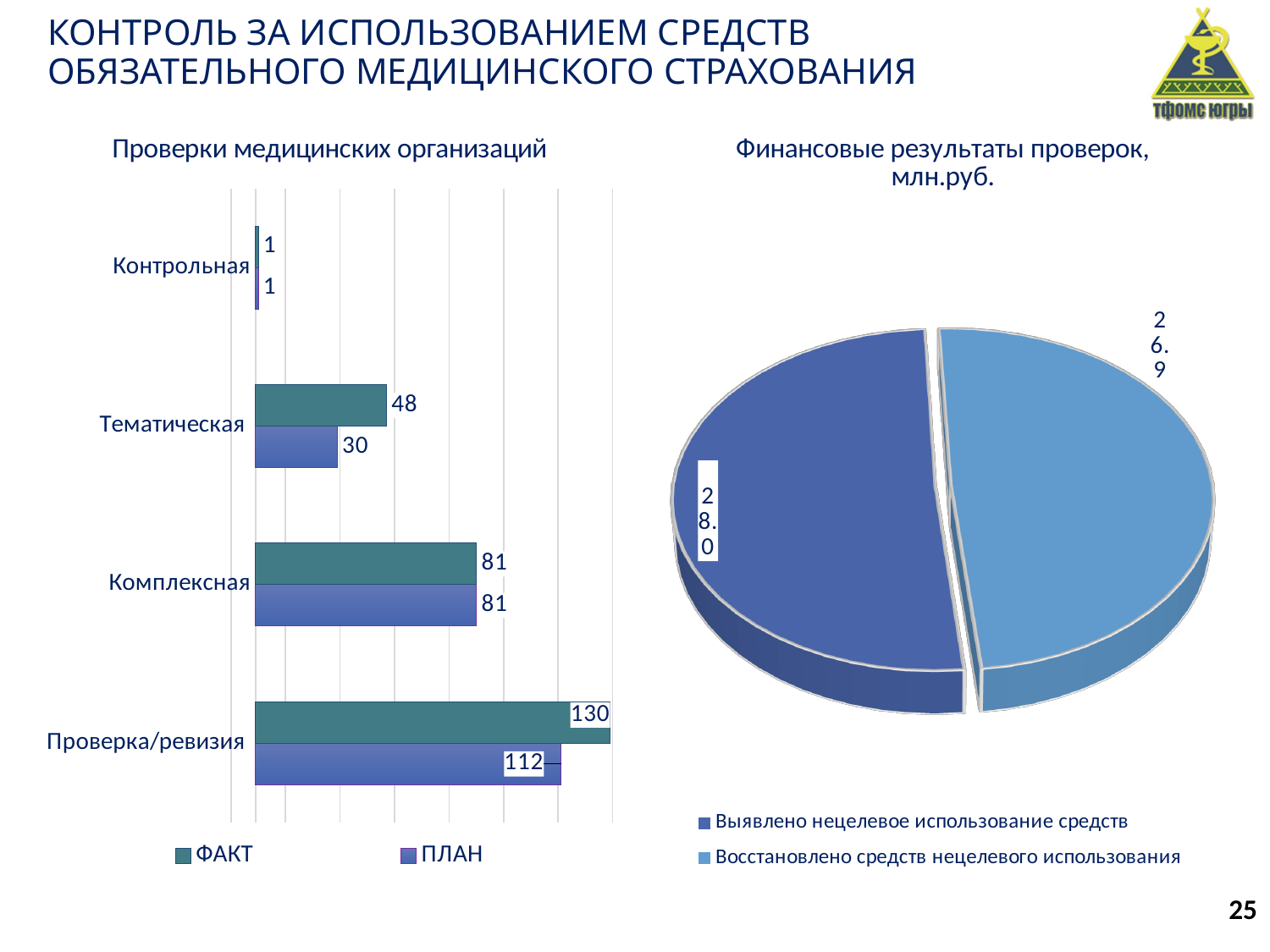
In the chart 'Проверки медицинских организаций', what is the ФАКТ value for Проверка/ревизия? 130 In the chart 'Проверки медицинских организаций', which is larger for Проверка/ревизия: ФАКТ or ПЛАН? ФАКТ In the pie chart 'Финансовые результаты проверок, млн.руб.', what is the value for 'Восстановлено средств нецелевого использования'? 26.9 How many categories are shown in the chart 'Проверки медицинских организаций'? 4 In the chart 'Проверки медицинских организаций', what is the ПЛАН value for Тематическая? 30 In the chart 'Проверки медицинских организаций', what is the ПЛАН value for Проверка/ревизия? 112 In the chart 'Проверки медицинских организаций', what is the difference between the ФАКТ and ПЛАН values for Тематическая? 18 How many series does the legend of the chart 'Проверки медицинских организаций' list? 2 In the chart 'Проверки медицинских организаций', which category has the lowest ПЛАН value? Контрольная In the pie chart 'Финансовые результаты проверок, млн.руб.', what is the value for 'Выявлено нецелевое использование средств'? 28.0 In the chart 'Проверки медицинских организаций', which category has the highest ФАКТ value? Проверка/ревизия What kind of chart is 'Проверки медицинских организаций'? Bar chart